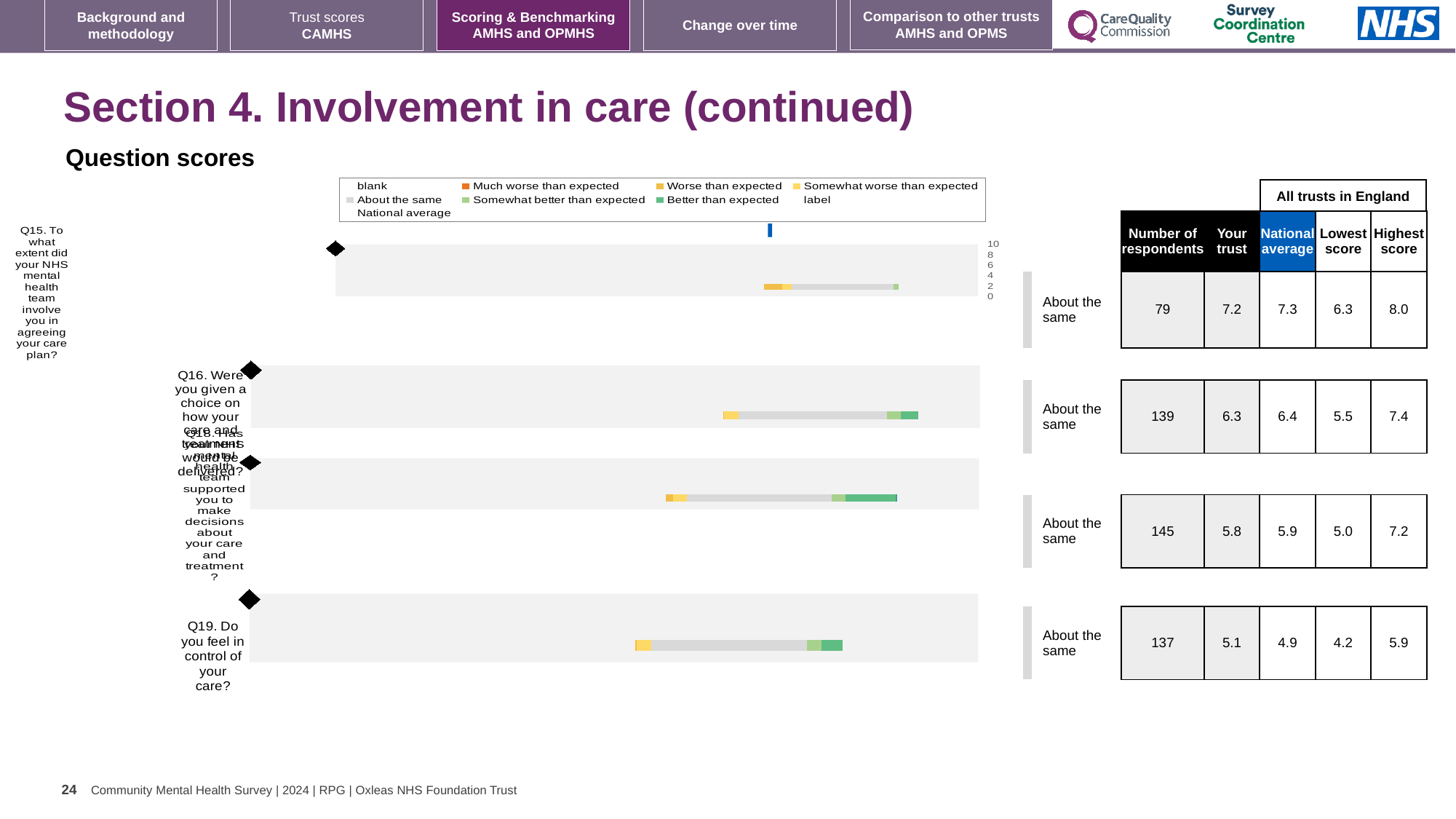
What is the national average score for Q19 (feeling in control of your care)? 4.9 Which question has the highest 'Your trust' score? Q15 What kind of chart is used to show the question scores? Bar chart For Q19, which is larger: the 'Your trust' score or the national average? Your trust Which question has the lowest 'Your trust' score? Q19 What is the 'Your trust' score for Q15 (involvement in agreeing your care plan)? 7.2 What is the lowest score among all trusts in England for Q16 (choice on how care and treatment would be delivered)? 5.5 What benchmark category is shown for each of the four questions on this slide? About the same How many questions are plotted in the question scores chart? 4 What is the difference between the highest score and the lowest score for Q15? 1.7 How many respondents answered Q18 (team supported you to make decisions)? 145 What is the highest score among all trusts in England for Q15? 8.0